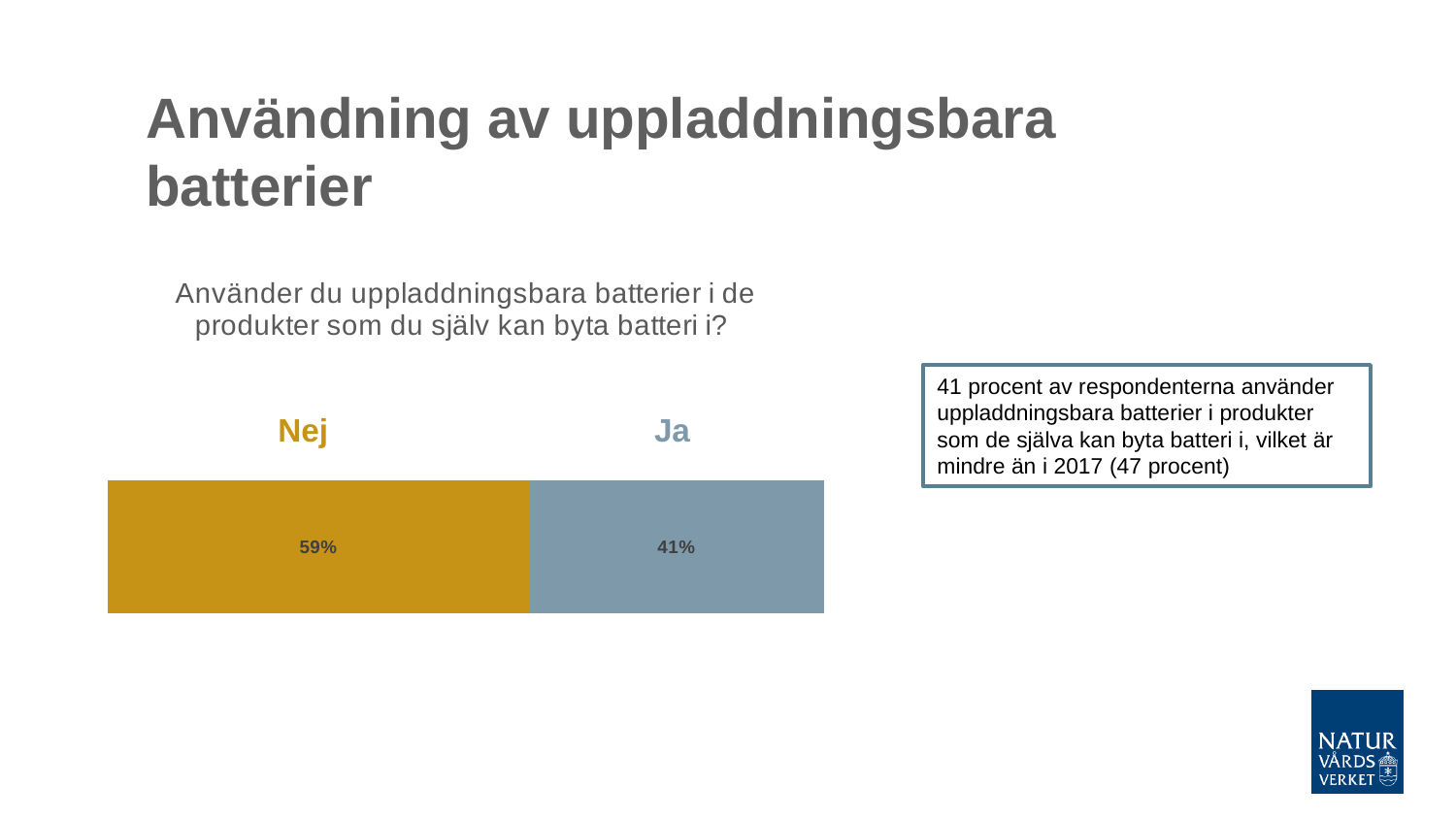
What is the difference in percentage points between the "Nej" and "Ja" shares? 18 percentage points Is the share for "Nej" greater or less than 50%? greater What colour is the "Nej" segment of the bar? Gold/yellow Is the share for "Ja" larger or smaller than the share for "Nej"? smaller Which response has the smaller share? Ja What percentage of respondents answered "Nej"? 59% What question does the chart present responses to? Använder du uppladdningsbara batterier i de produkter som du själv kan byta batteri i? How many response categories are shown in the bar? 2 What percentage of respondents answered "Ja"? 41% What is the total of the two segments in the stacked bar? 100% What kind of chart is shown on the slide? A stacked bar chart Which response has the larger share, "Nej" or "Ja"? Nej